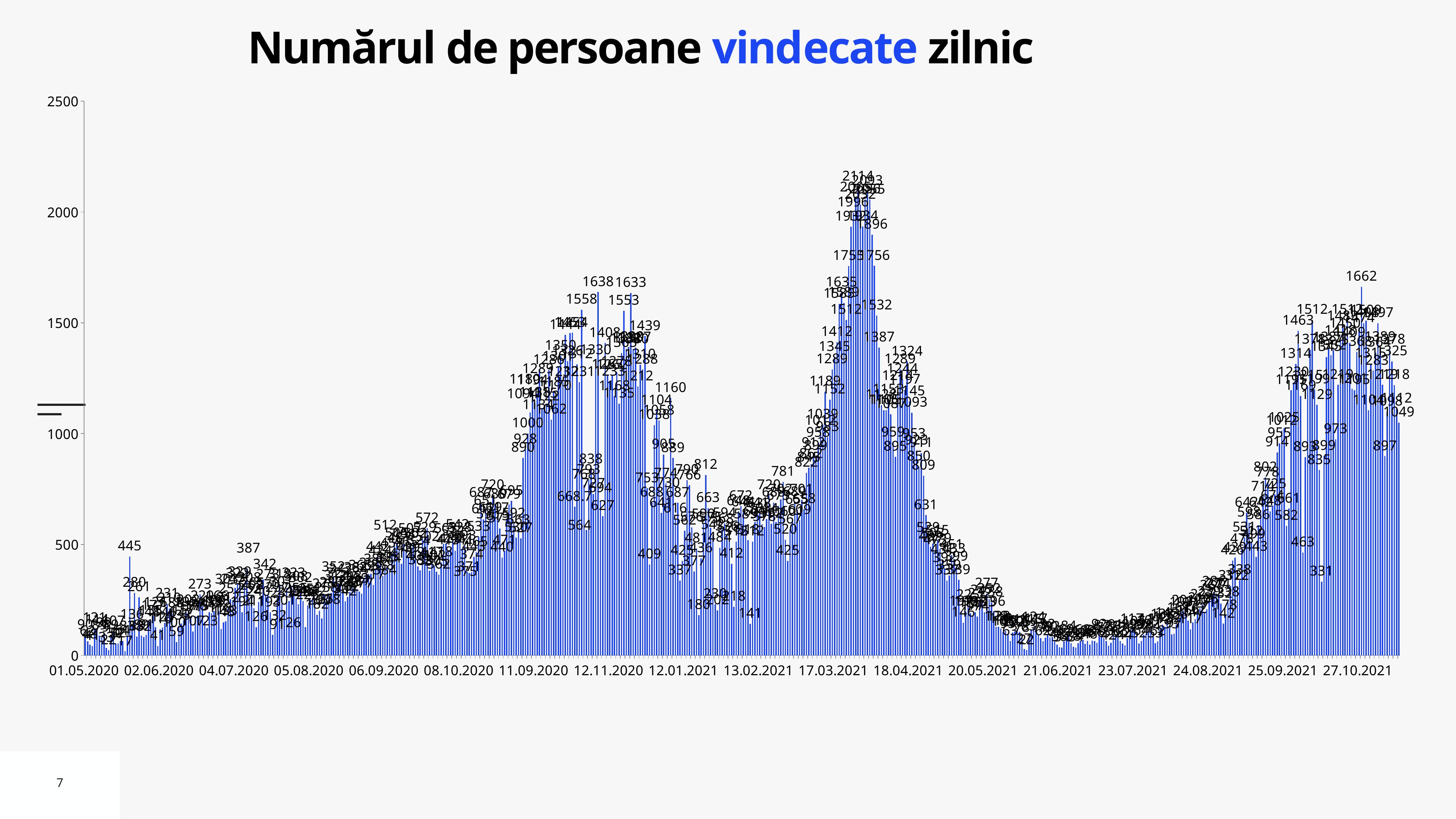
What colour are the bars in the chart? blue Do the values rise or fall between 24.08.2021 and 27.10.2021? rise Are the bars around 21.06.2021 greater or less than 500? less Is the highest bar on the chart greater or less than 2000? greater Which peak is higher: the one near 18.04.2021 or the one near 27.10.2021? the one near 18.04.2021 What is the highest labelled value in the peak between 11.09.2020 and 12.11.2020? 1638 What is the title of the chart? Numărul de persoane vindecate zilnic Do the values rise or fall between 20.05.2021 and 21.06.2021? fall What kind of chart is shown on the slide? bar chart What is the highest labelled value in the peak near 27.10.2021? 1662 What is the difference between the overall peak value of 2114 and the late-2021 peak value of 1662? 452 What is the highest daily value labelled on the chart? 2114